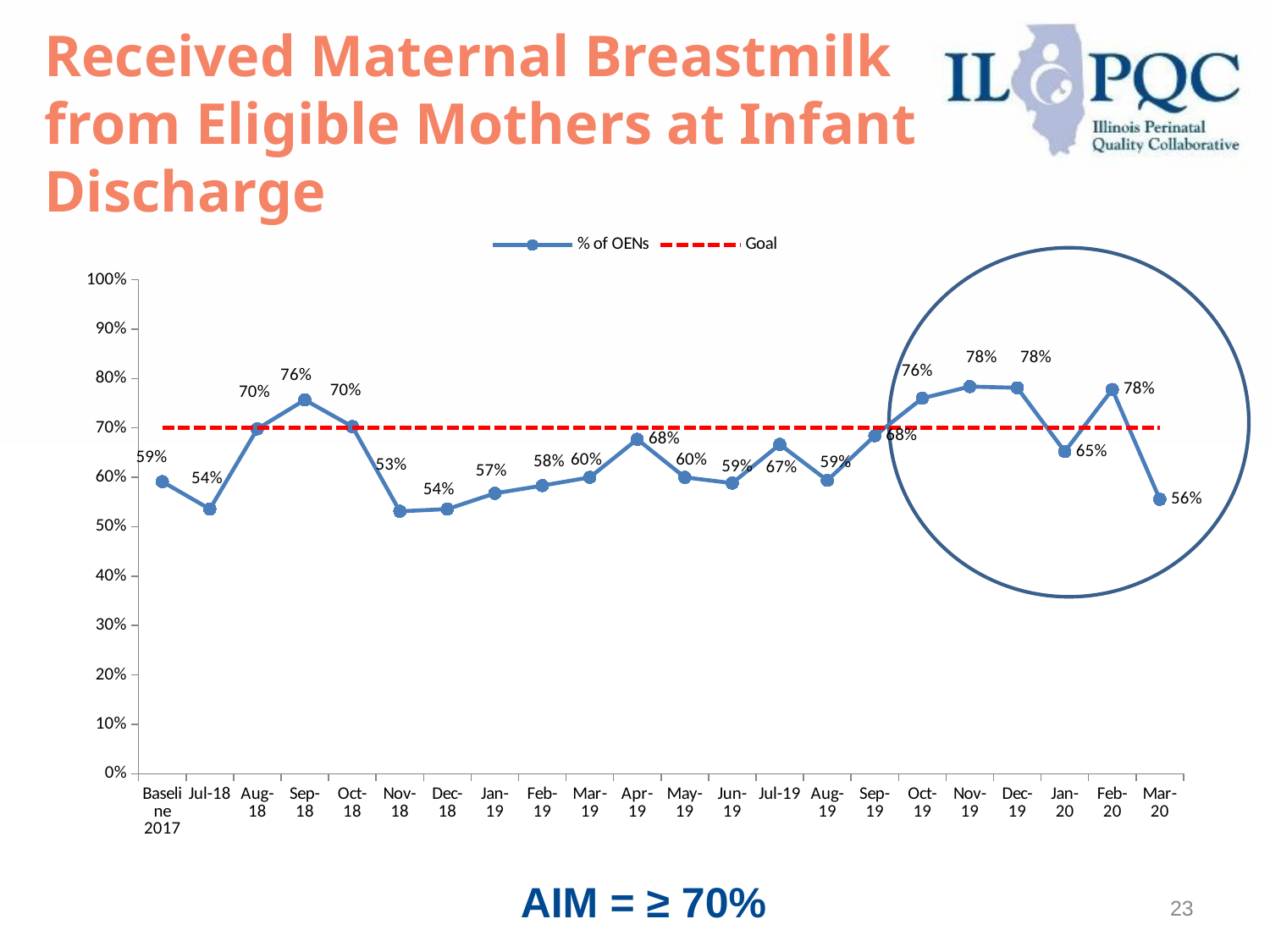
What kind of chart is shown on the slide? Line chart What is the value for Sep-18? 76% What is the value for Jan-20? 65% What is the value for the Baseline 2017 point? 59% How many data points are plotted on the % of OENs line? 22 Is the value for Nov-19 greater or less than 70%? greater Which is larger, the value for Oct-19 or the value for Jan-20? Oct-19 How many series does the legend list? 2 What is the value for Mar-20? 56% What is the difference between the values for Sep-18 and Jul-18? 22 percentage points Which month has the lowest value on the % of OENs line? Nov-18 What is the highest value reached by the % of OENs line? 78%